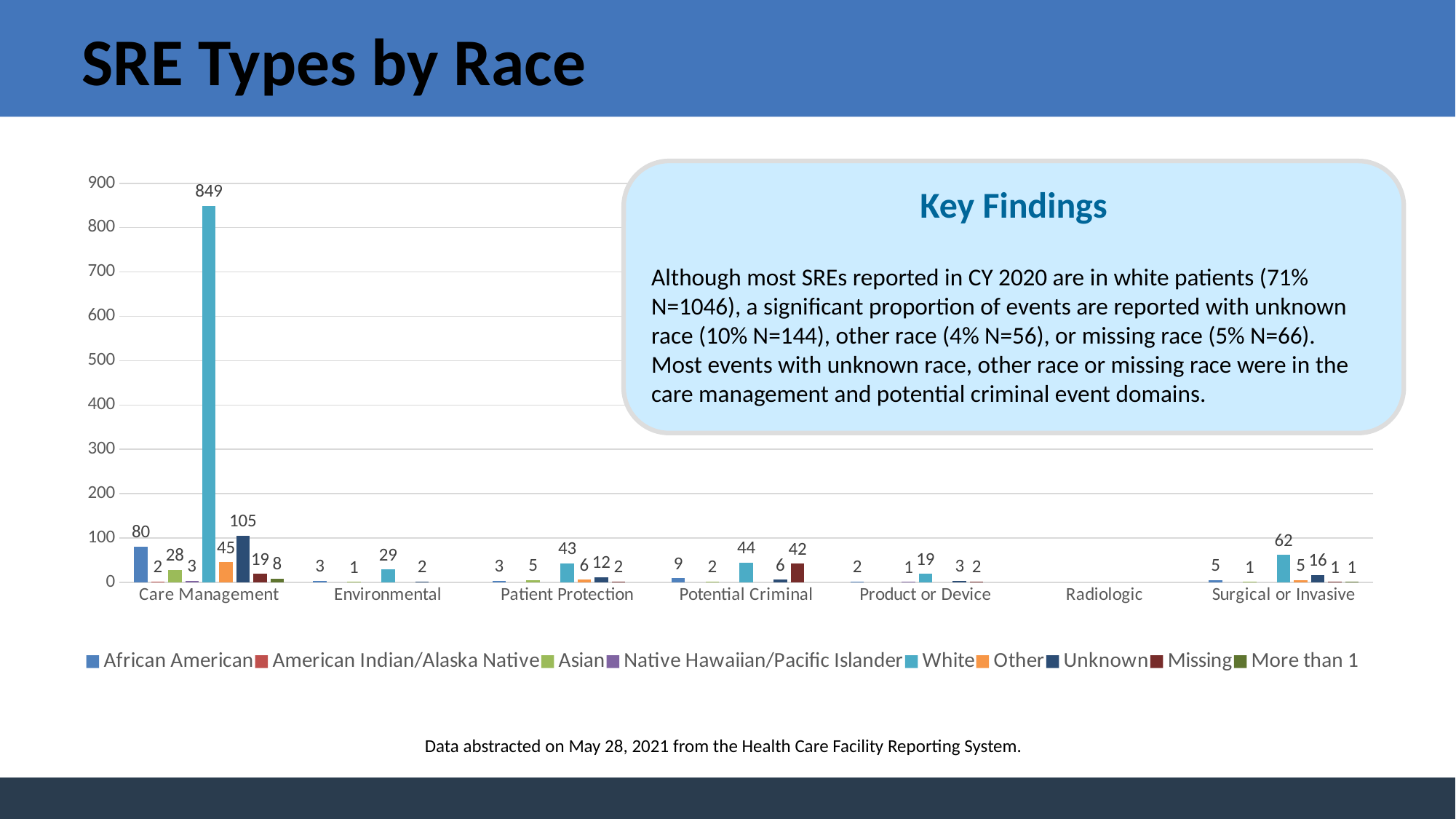
In the Potential Criminal category, which is larger: the White value or the Missing value? White What is the difference between the White and Unknown values in the Care Management category? 744 In which category is the White series highest? Care Management How many series does the legend list? 9 What is the title of the chart? SRE Types by Race What is the value for White in the Surgical or Invasive category? 62 What is the value for African American in the Care Management category? 80 Is the value for White in Care Management greater or less than 800? greater How many SRE type categories are shown on the x axis? 7 What kind of chart is shown on the slide? bar chart What is the value for White in the Care Management category? 849 What is the value for Unknown in the Care Management category? 105